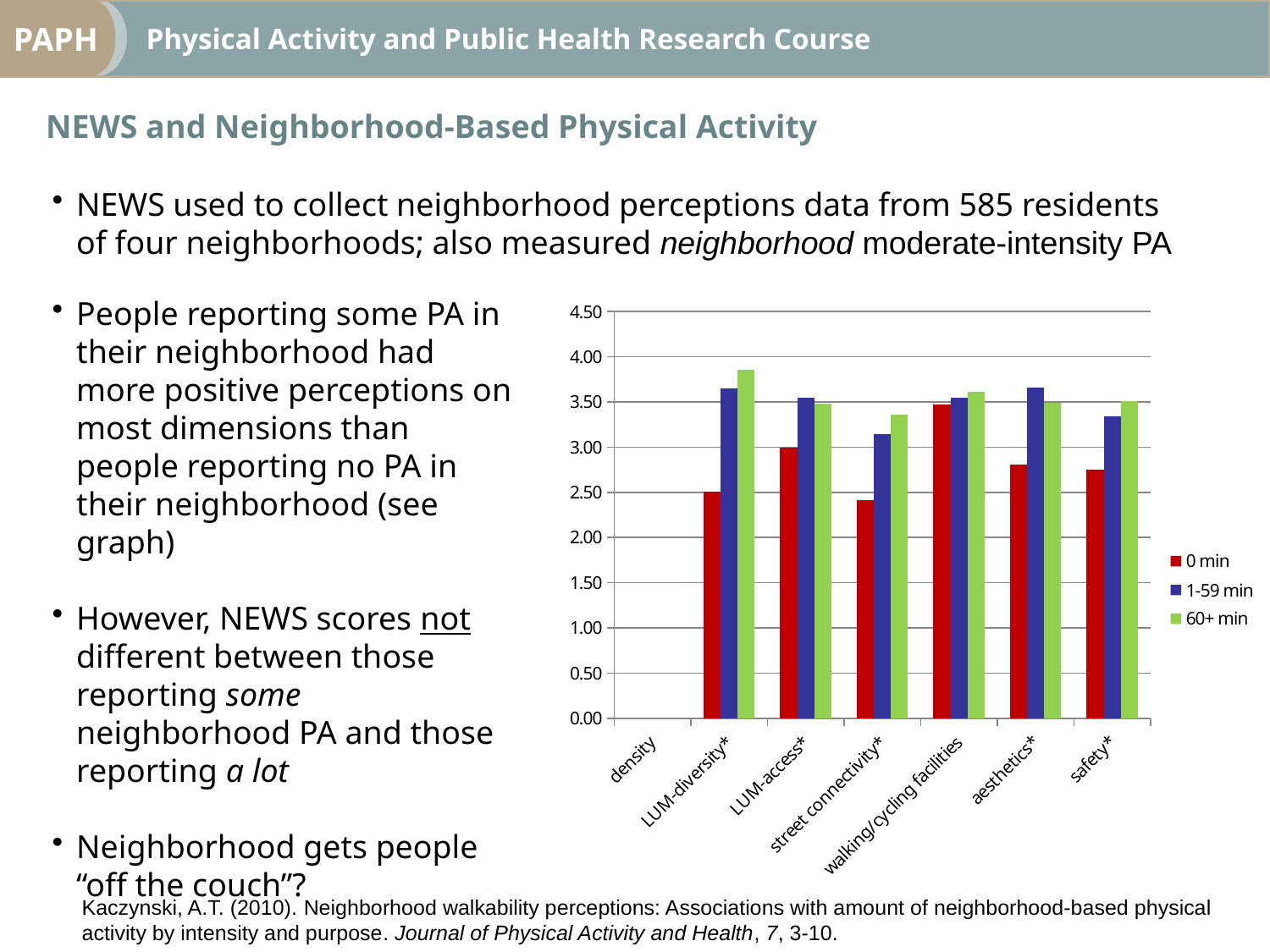
Is the 0 min value for street connectivity* greater or less than 2.50? less What kind of chart is shown on the slide? bar chart For aesthetics*, which is larger: the 0 min value or the 1-59 min value? 1-59 min Which category on the x axis has no bars plotted? density For LUM-diversity*, which is larger: the 1-59 min value or the 60+ min value? 60+ min Which category has the highest 60+ min value in the chart? LUM-diversity* Is the 1-59 min value for safety* greater or less than 3.00? greater Is the 60+ min value for LUM-diversity* greater or less than 3.50? greater How many categories are labeled along the x axis of the chart? 7 What are the three series named in the chart legend? 0 min, 1-59 min, 60+ min How many series does the chart legend list? 3